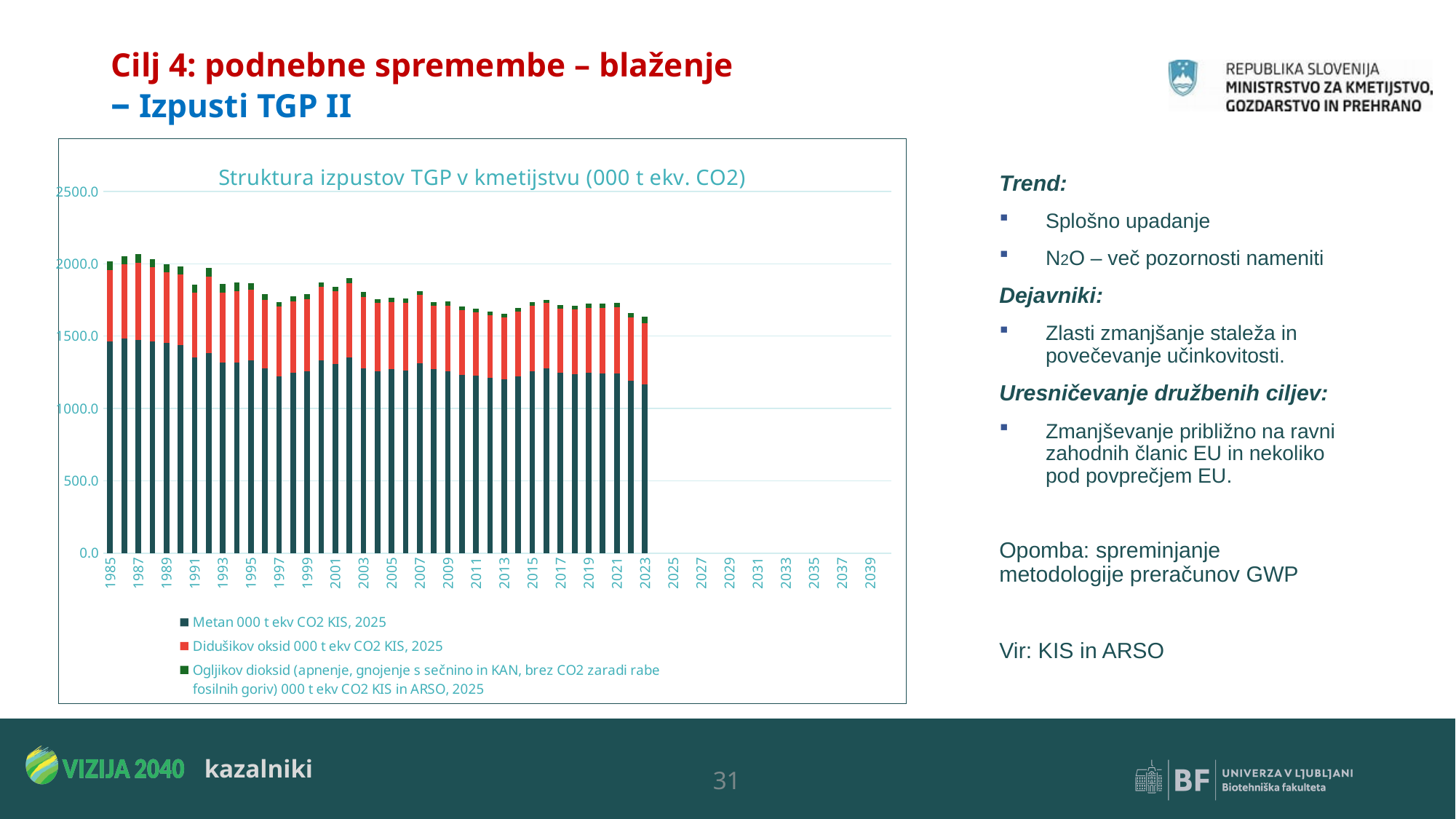
Which year has the larger total stacked value, 1985 or 2023? 1985 Is the value of the Metan series for 2023 greater or less than 1500? less Which year has the larger Metan value, 1987 or 2021? 1987 Is the total stacked value for 1985 greater or less than 1500? greater Is the total stacked value for 2023 greater or less than 2000? less Which series makes up the largest part of each stacked bar? Metan 000 t ekv CO2 KIS, 2025 How many series does the chart's legend list? 3 What kind of chart is shown on the slide? stacked bar chart Which colour represents the series 'Didušikov oksid 000 t ekv CO2 KIS, 2025'? red Do the total emissions generally rise or fall from 1985 to 2023? fall What is the title of the chart? Struktura izpustov TGP v kmetijstvu (000 t ekv. CO2)